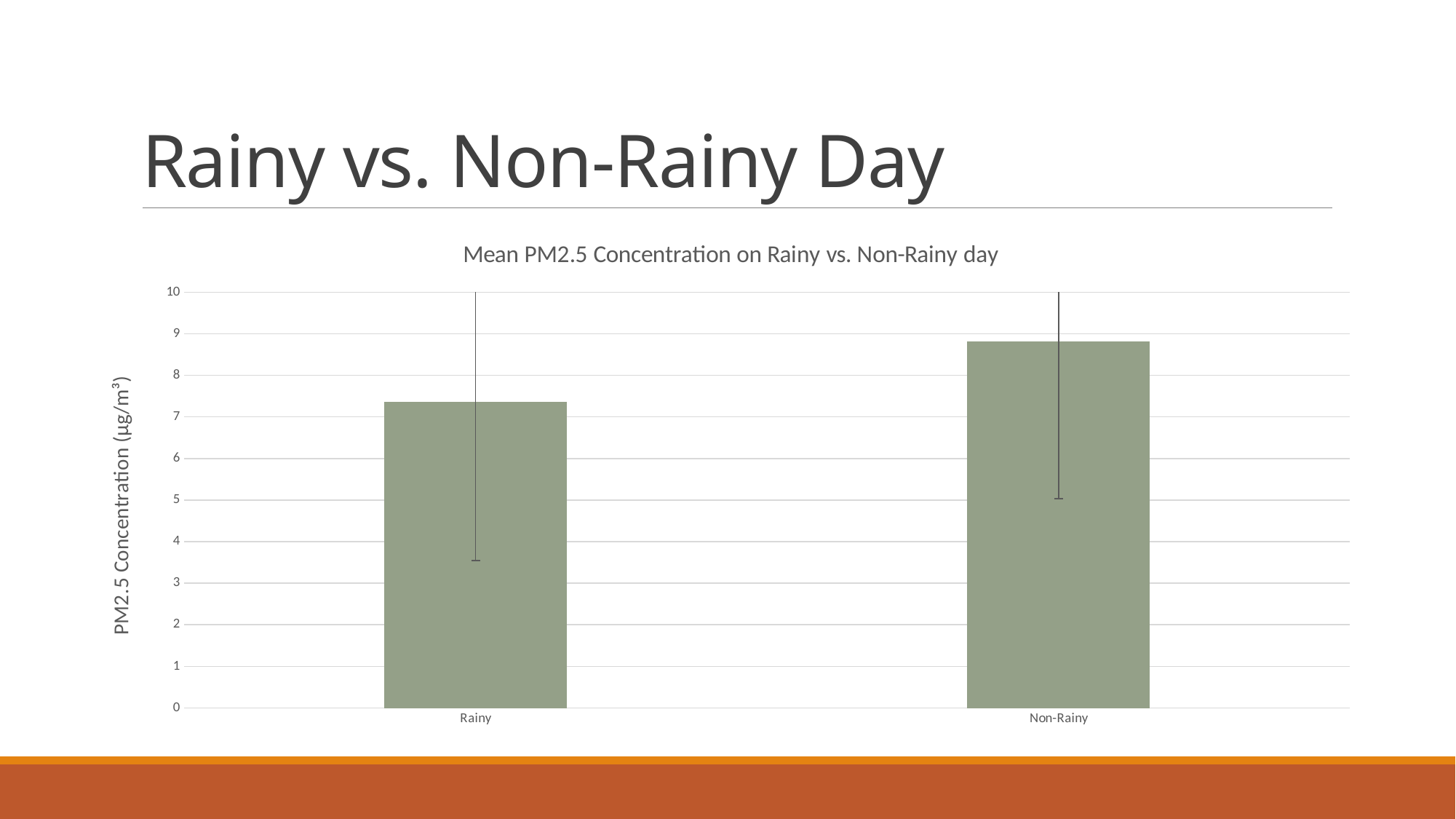
Is the mean PM2.5 concentration for Non-Rainy greater or less than 9? less What is the maximum value shown on the y axis? 10 What is the title of the chart? Mean PM2.5 Concentration on Rainy vs. Non-Rainy day How many categories are plotted on the x axis? 2 Which category has the highest mean PM2.5 concentration? Non-Rainy What is the label of the y axis? PM2.5 Concentration (µg/m³) Which category has the lowest mean PM2.5 concentration? Rainy What type of chart is shown on the slide? bar chart Is the mean PM2.5 concentration for Rainy greater or less than 7? greater Which is larger, the mean PM2.5 concentration on Rainy days or on Non-Rainy days? Non-Rainy Is the mean PM2.5 concentration for Rainy greater or less than 8? less